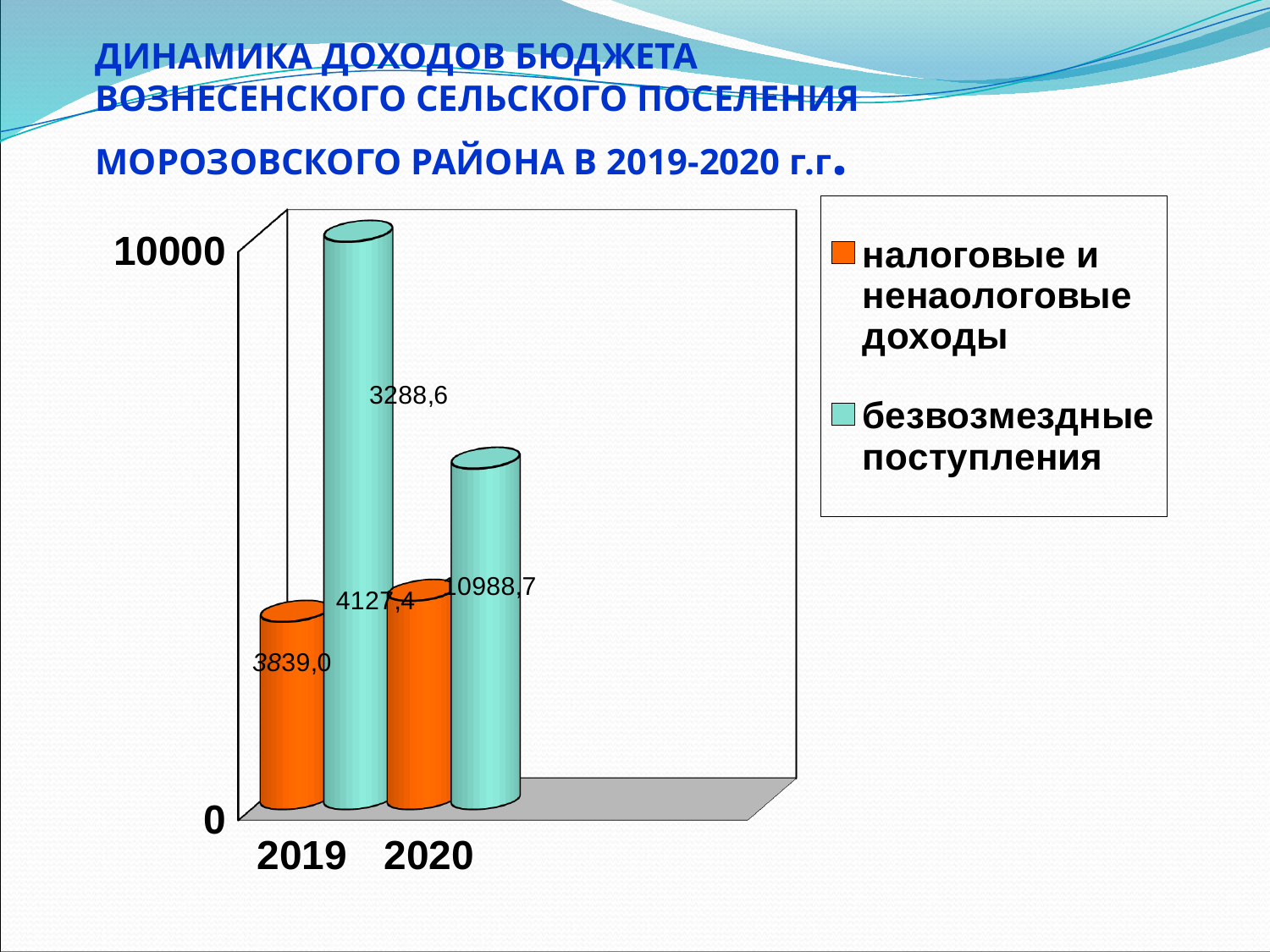
Which years are shown on the x axis? 2019 and 2020 How many years are shown on the x axis of the chart? 2 Which series is shown in orange in the legend? налоговые и ненаологовые доходы What is the value of налоговые и ненаологовые доходы for 2019? 3839,0 Do the values for налоговые и ненаологовые доходы rise or fall from 2019 to 2020? rise How many series does the legend list? 2 Is the value of налоговые и ненаологовые доходы for 2019 greater or less than 10000? less Which year has the larger value for налоговые и ненаологовые доходы, 2019 or 2020? 2020 What kind of chart is shown on the slide? bar chart What is the highest value labelled on the vertical axis? 10000 What is the difference between the налоговые и ненаологовые доходы values for 2020 and 2019? 288,4 What is the value of налоговые и ненаологовые доходы for 2020? 4127,4